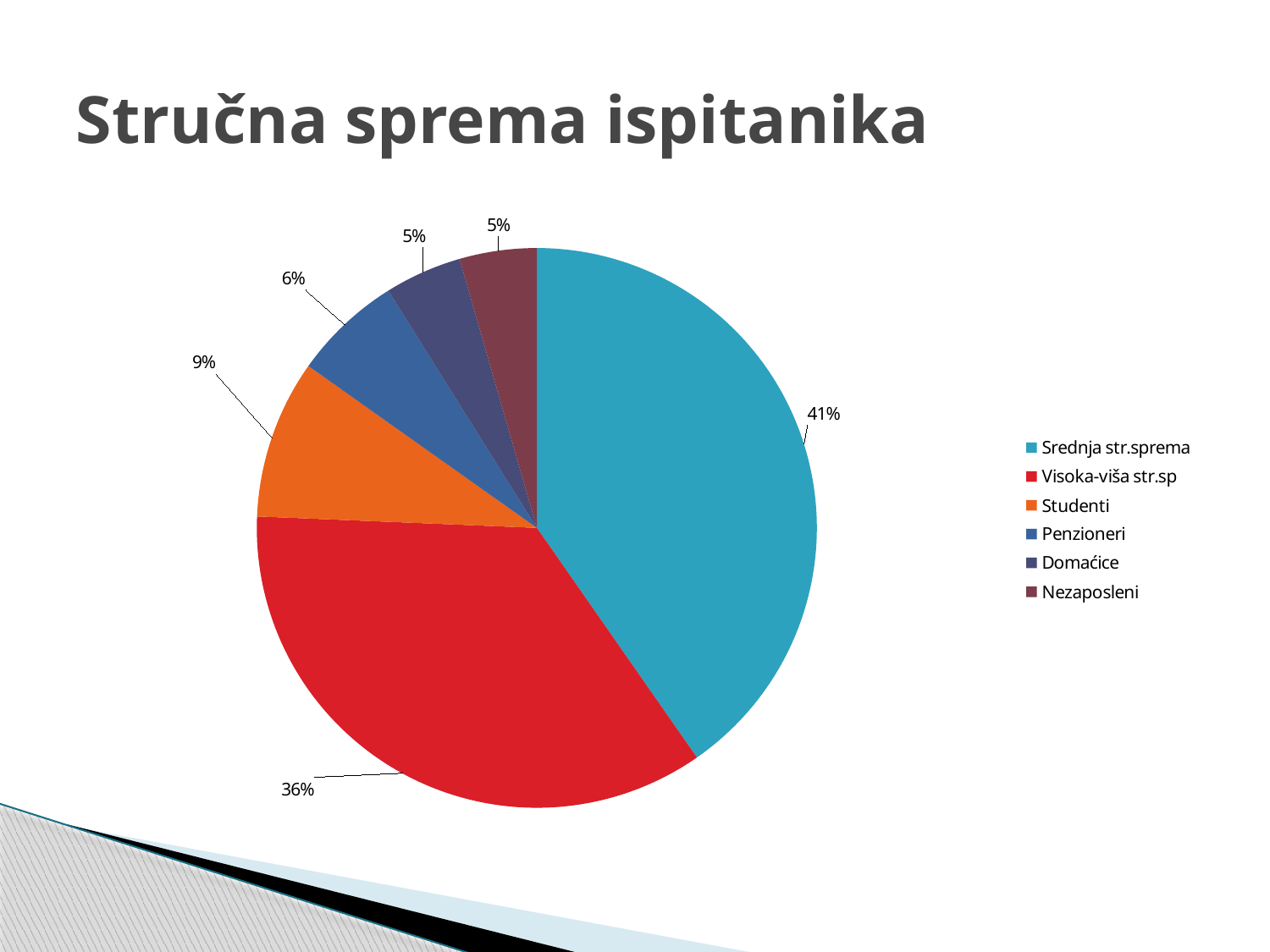
What share of the pie does Srednja str.sprema have? 41% Which category has the largest slice of the pie? Srednja str.sprema What is the value for Penzioneri? 6% Which is larger, the slice for Studenti or the slice for Penzioneri? Studenti What is the title of the slide? Stručna sprema ispitanika What is the value for Domaćice? 5% What type of chart is shown on the slide? pie chart What colour is the slice for Visoka-viša str.sp? red What is the value for Studenti? 9% What share of the pie does Visoka-viša str.sp have? 36% How many categories does the pie chart have? 6 What is the difference between the shares of Srednja str.sprema and Visoka-viša str.sp? 5%